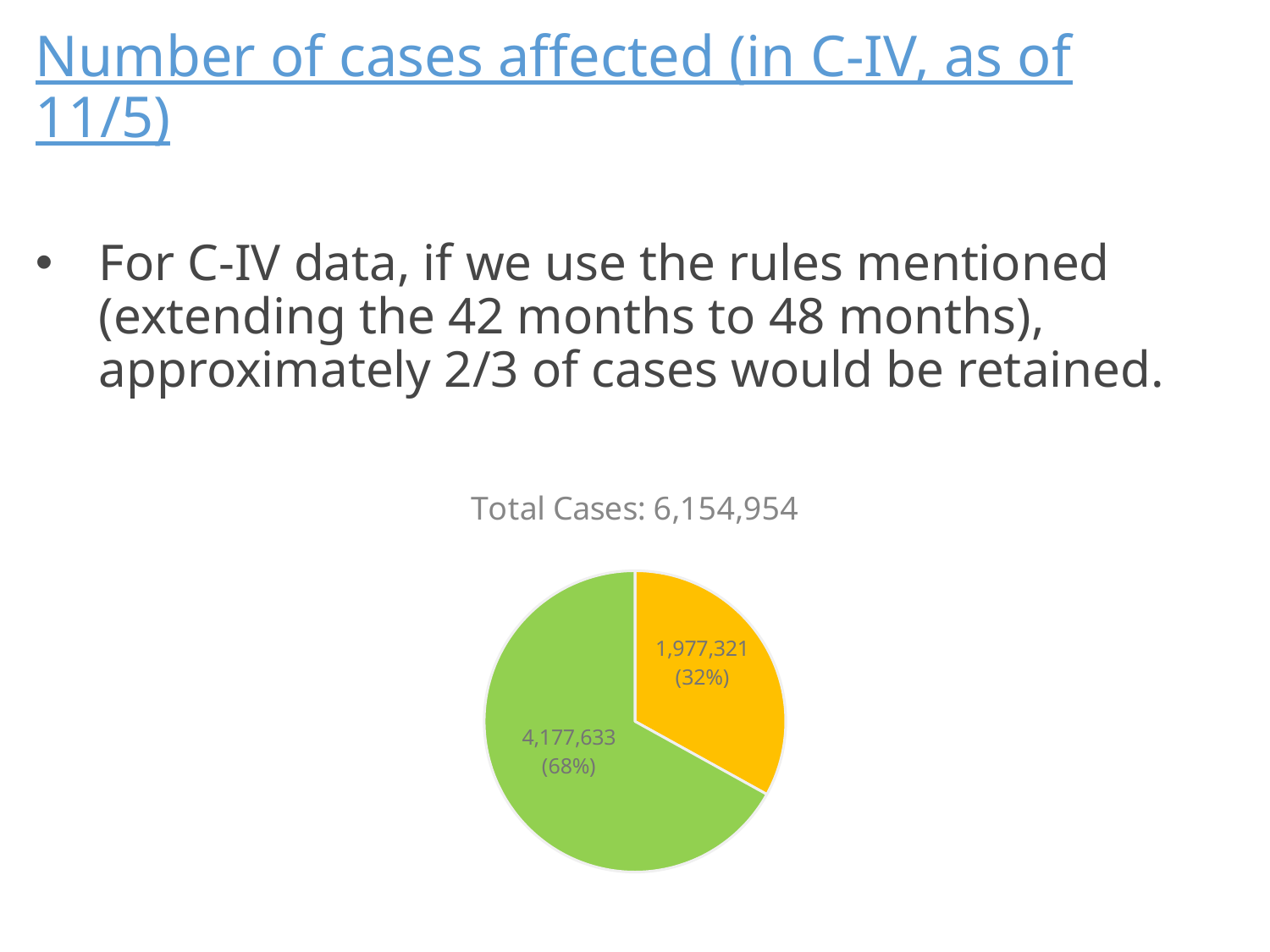
What share of the pie does the green slice represent? 68% What value is shown on the orange slice of the pie chart? 1,977,321 Which slice of the pie chart is the largest? The green slice (4,177,633) What kind of chart is shown on the slide? Pie chart What is the total of the two slice values in the pie chart? 6,154,954 Which slice of the pie chart is the smallest? The orange slice (1,977,321) What is the title of the pie chart? Total Cases: 6,154,954 What value is shown on the green slice of the pie chart? 4,177,633 How many slices does the pie chart have? 2 What share of the pie does the orange slice represent? 32% What is the difference between the green slice value and the orange slice value? 2,200,312 Is the green slice or the orange slice larger? The green slice